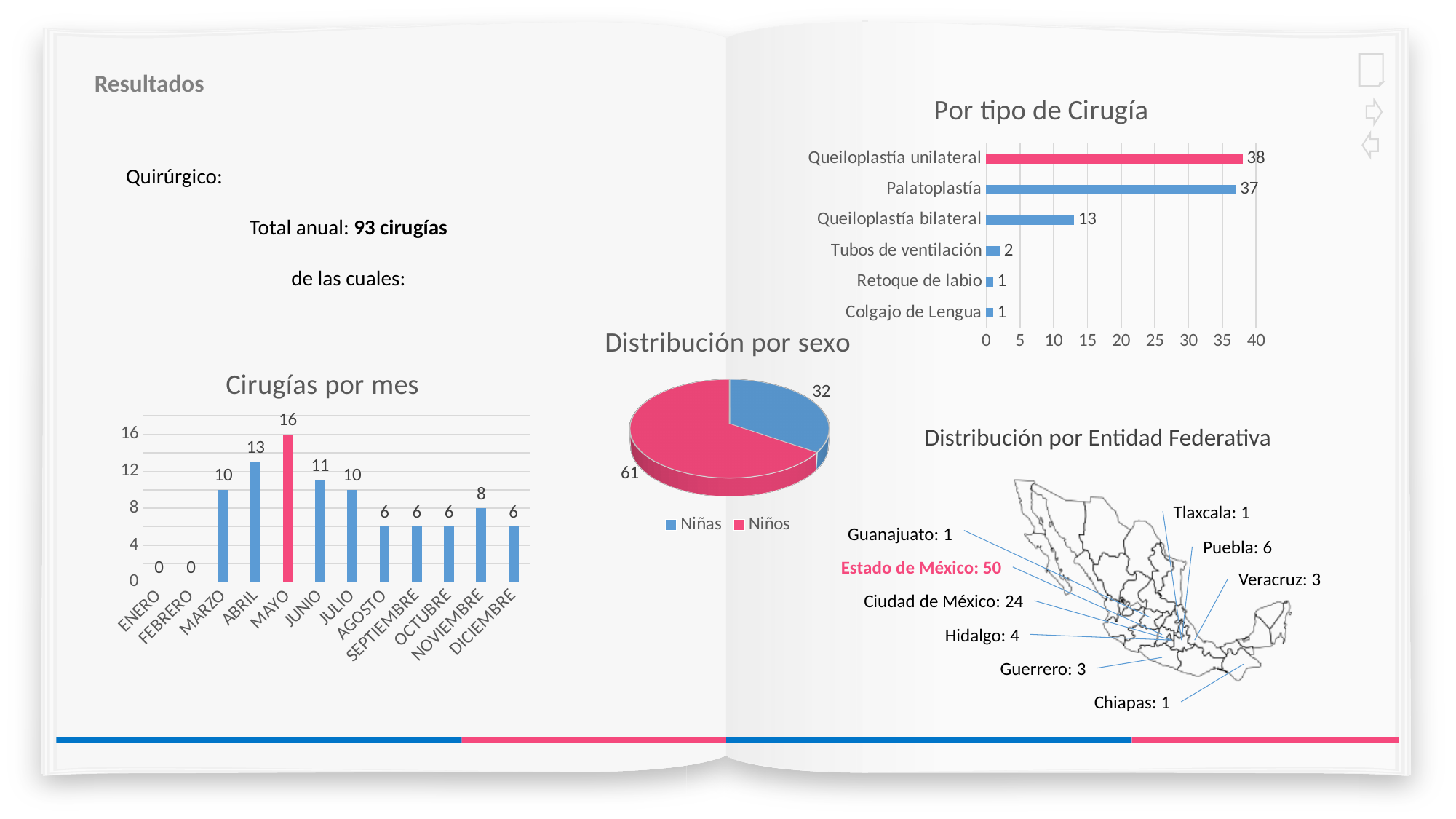
In the 'Cirugías por mes' chart, which is larger, the value for JUNIO or the value for NOVIEMBRE? JUNIO In the 'Por tipo de Cirugía' chart, what is the difference between Queiloplastía unilateral and Queiloplastía bilateral? 25 In the 'Cirugías por mes' chart, which month has the highest value? MAYO What kind of chart is 'Cirugías por mes'? bar chart In the 'Por tipo de Cirugía' chart, which category has the highest value? Queiloplastía unilateral In the 'Cirugías por mes' chart, what is the value for MAYO? 16 In the 'Distribución por sexo' chart, which slice is larger, Niñas or Niños? Niños In the 'Cirugías por mes' chart, how many months are shown on the x axis? 12 In the 'Distribución por sexo' pie chart, what is the value for Niños? 61 How many series does the legend of the 'Distribución por sexo' chart list? 2 In the 'Por tipo de Cirugía' chart, what is the value for Palatoplastía? 37 In the 'Cirugías por mes' chart, what is the difference between the values for ABRIL and MARZO? 3